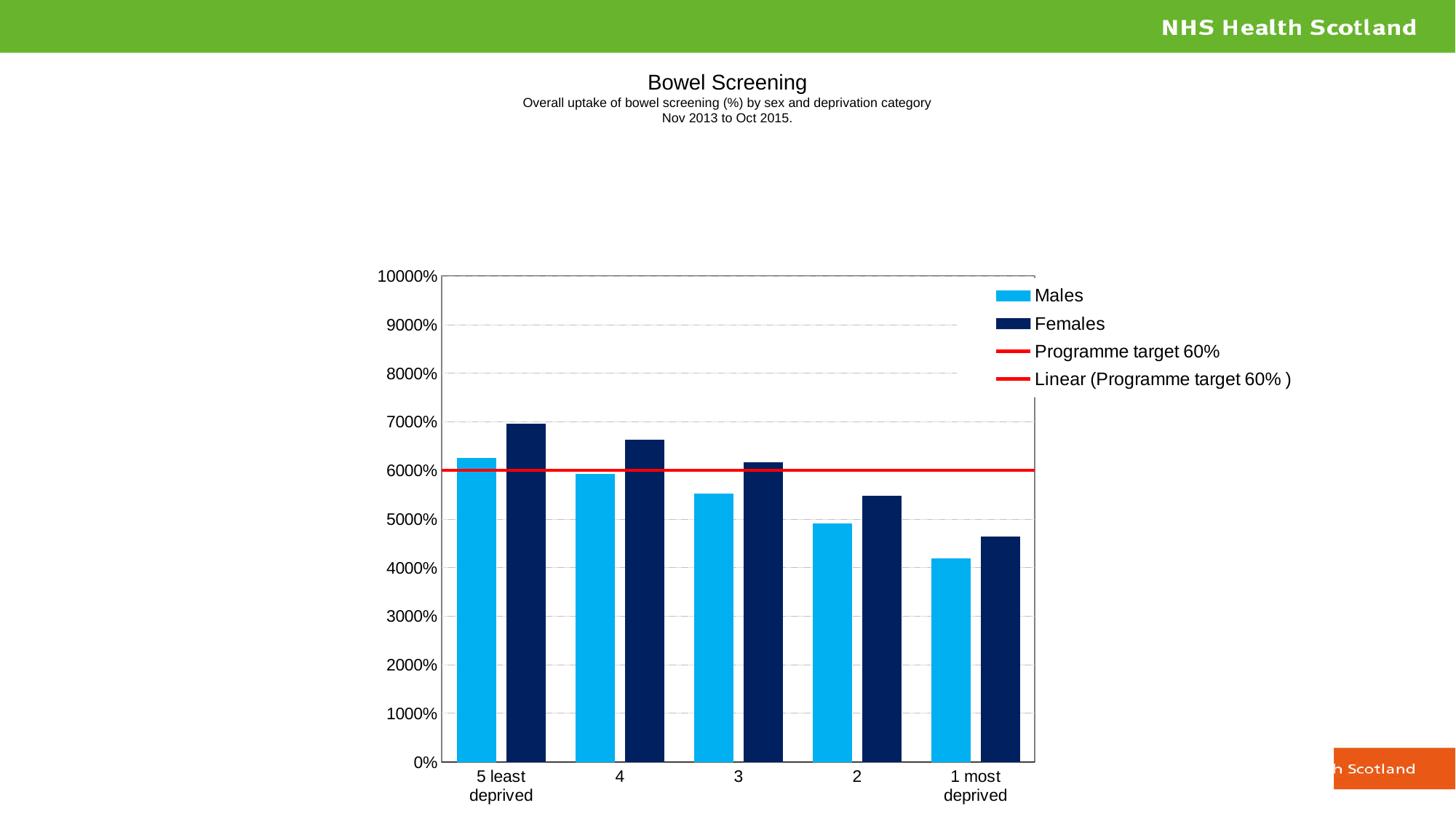
What is the title of the chart? Bowel Screening How many deprivation categories are shown on the x axis? 5 Is the value for Males in the 1 most deprived category greater or less than 5000%? less Which deprivation category has the lowest value for Males? 1 most deprived Which deprivation category has the highest value for Females? 5 least deprived Is the value for Females in the 5 least deprived category greater or less than 6000%? greater How many entries does the legend list? 4 In deprivation category 4, which is larger, the value for Males or for Females? Females Is the value for Males in deprivation category 3 greater or less than 6000%? less Do the values for Males rise or fall moving from 5 least deprived to 1 most deprived along the x axis? fall What kind of chart is shown on the slide? bar chart What colour is the Programme target 60% line in the legend? red